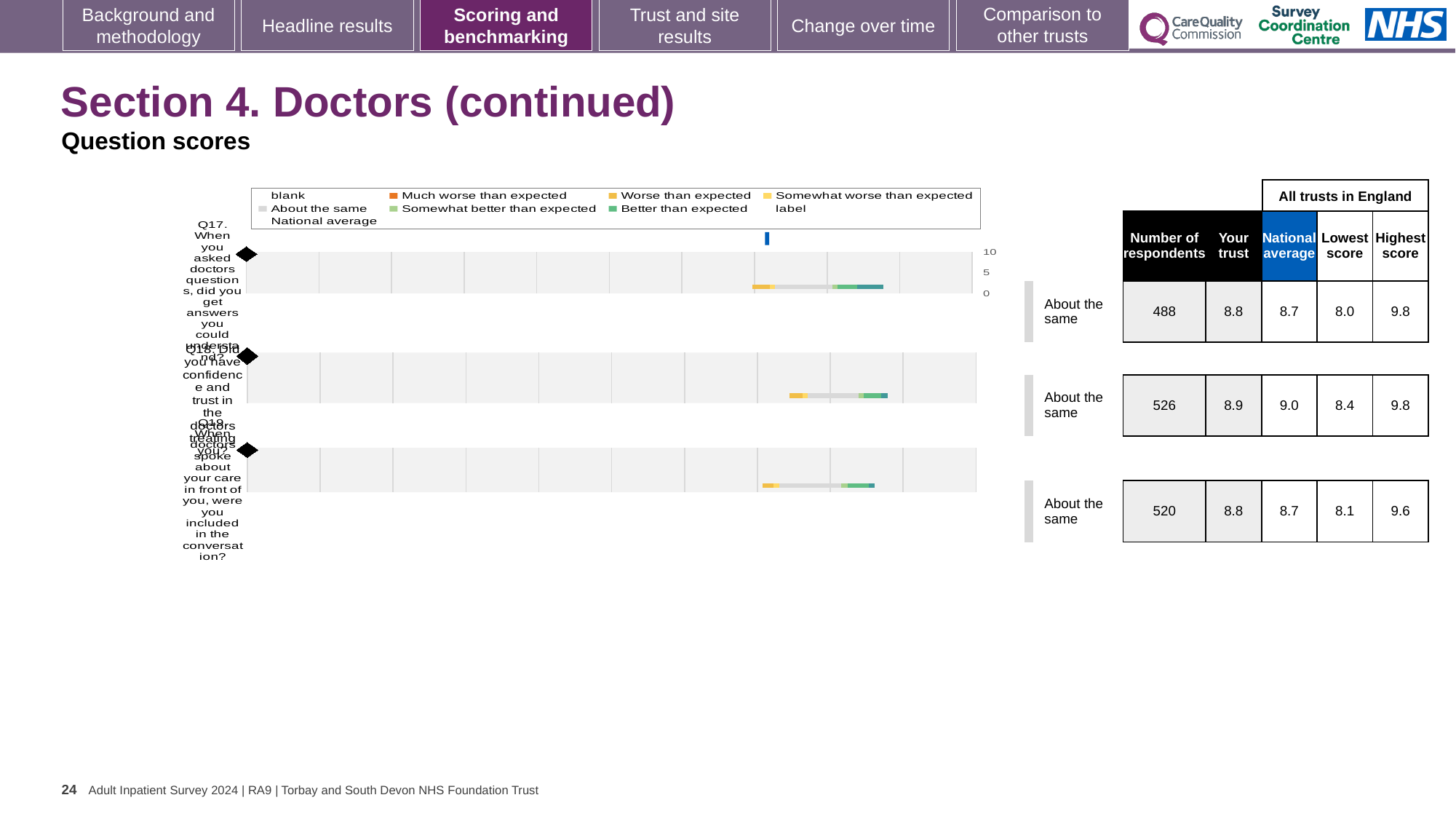
For Q18, which is larger: the 'Your trust' score or the national average? National average What kind of chart is used to show the question scores on this slide? bar chart What is the highest tick value shown on the chart's score axis? 10 What is the number of respondents for Q17 (When you asked doctors questions, did you get answers you could understand)? 488 What is the lowest score among all trusts in England for Q19? 8.1 What is the 'Your trust' score for Q18 (Did you have confidence and trust in the doctors treating you)? 8.9 What benchmark category is shown next to each of the three questions in the chart? About the same Which question has the highest number of respondents? Q18 How many questions (rows) are plotted in the chart? 3 What is the highest score among all trusts in England for Q18? 9.8 For Q17, what is the difference between the highest score and the lowest score among all trusts in England? 1.8 What is the national average for Q19 (When doctors spoke about your care in front of you, were you included in the conversation)? 8.7